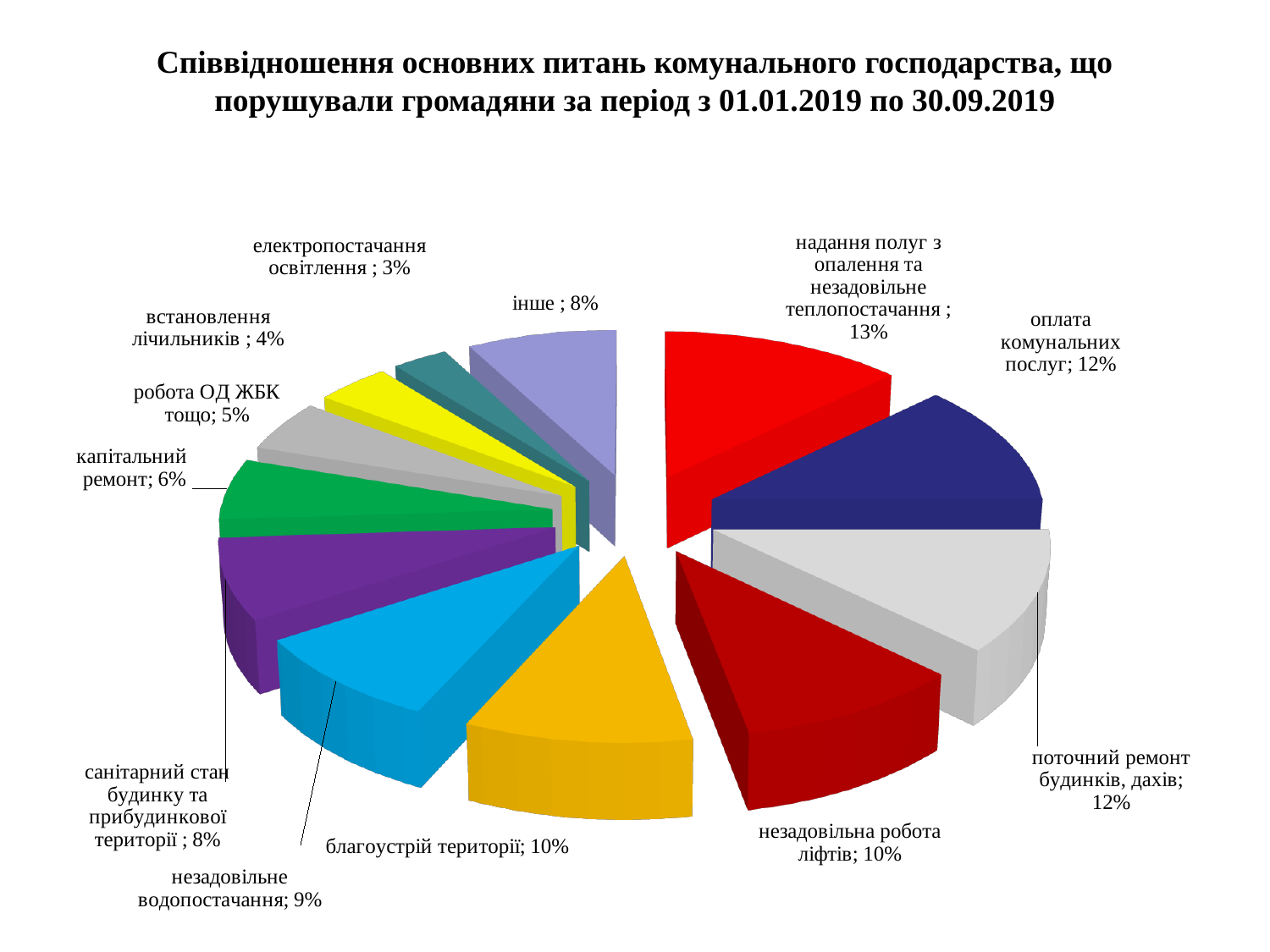
Which category has the largest share of the pie? надання полуг з опалення та незадовільне теплопостачання What share of the pie is labelled "надання полуг з опалення та незадовільне теплопостачання"? 13% What period does the chart title say the data covers? з 01.01.2019 по 30.09.2019 How many slices does the pie chart have? 12 What is the combined share of "незадовільна робота ліфтів" and "благоустрій території"? 20% What percentage is shown for "благоустрій території"? 10% What percentage is shown for "незадовільне водопостачання"? 9% Which category has the smallest share of the pie? електропостачання освітлення What percentage is shown for "капітальний ремонт"? 6% Which is larger: the share for "санітарний стан будинку та прибудинкової території" or the share for "робота ОД ЖБК тощо"? санітарний стан будинку та прибудинкової території What kind of chart is shown on the slide? pie chart What is the difference in percentage points between "оплата комунальних послуг" and "встановлення лічильників"? 8